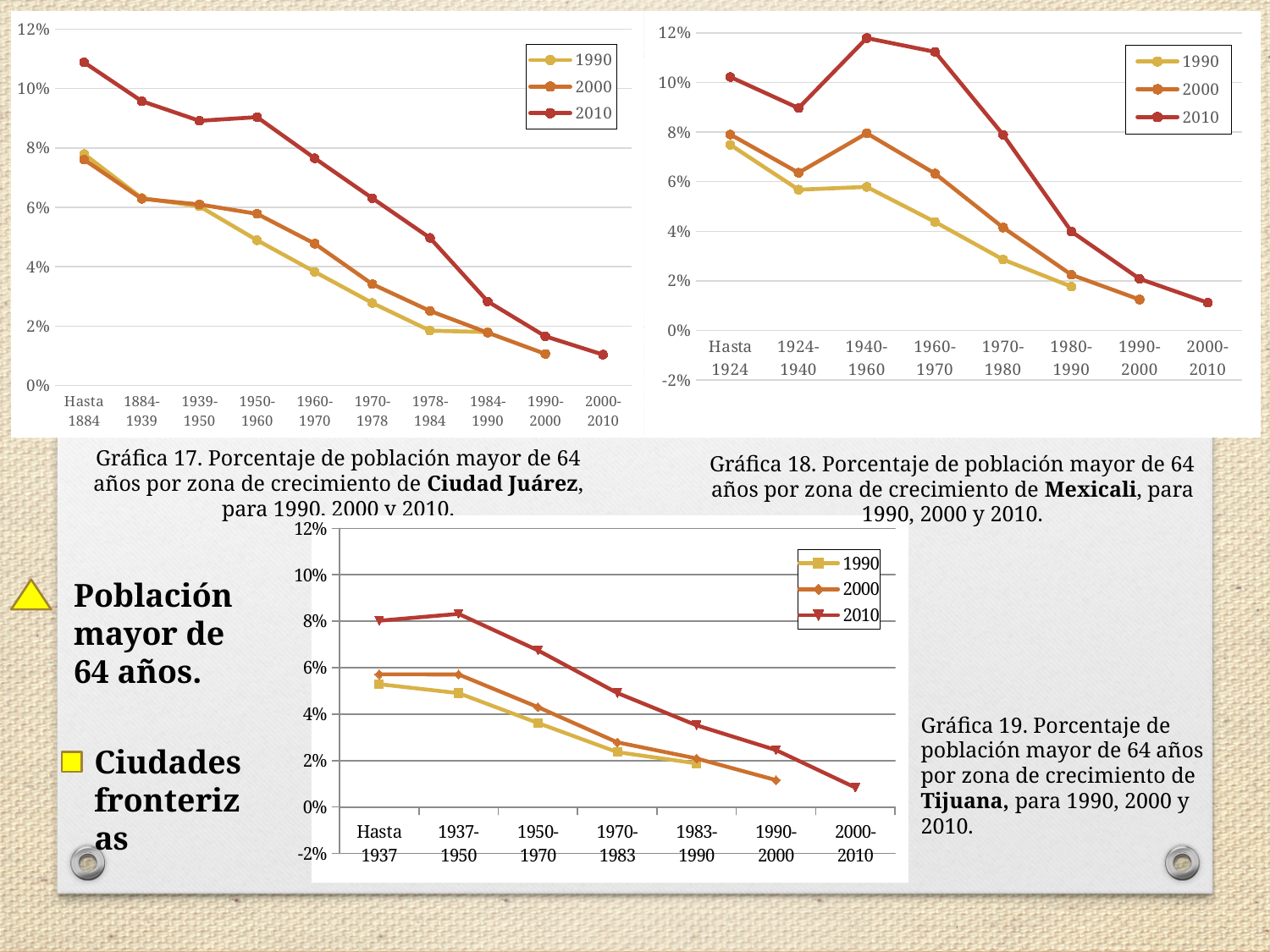
In Gráfica 19 (Tijuana), which growth zone has the highest 2010 value? 1937-1950 In Gráfica 19 (Tijuana), is the 1990 value for 'Hasta 1937' greater or less than 4%? greater How many growth-zone categories are shown on the x axis of Gráfica 19 (Tijuana)? 7 Which city does Gráfica 19 refer to? Tijuana What type of chart is Gráfica 17 (Ciudad Juárez)? line chart In Gráfica 18 (Mexicali), is the 2010 value for '1940-1960' greater or less than 10%? greater In Gráfica 18 (Mexicali), which growth zone has the highest 2010 value? 1940-1960 How many growth-zone categories are shown on the x axis of Gráfica 17 (Ciudad Juárez)? 10 In Gráfica 17 (Ciudad Juárez), does the 2010 series rise or fall from 'Hasta 1884' to '2000-2010'? fall In Gráfica 18 (Mexicali), which series is higher for '1970-1980': 1990 or 2010? 2010 How many series does the legend of Gráfica 18 (Mexicali) list? 3 In Gráfica 17 (Ciudad Juárez), is the 2010 value for 'Hasta 1884' greater or less than 10%? greater